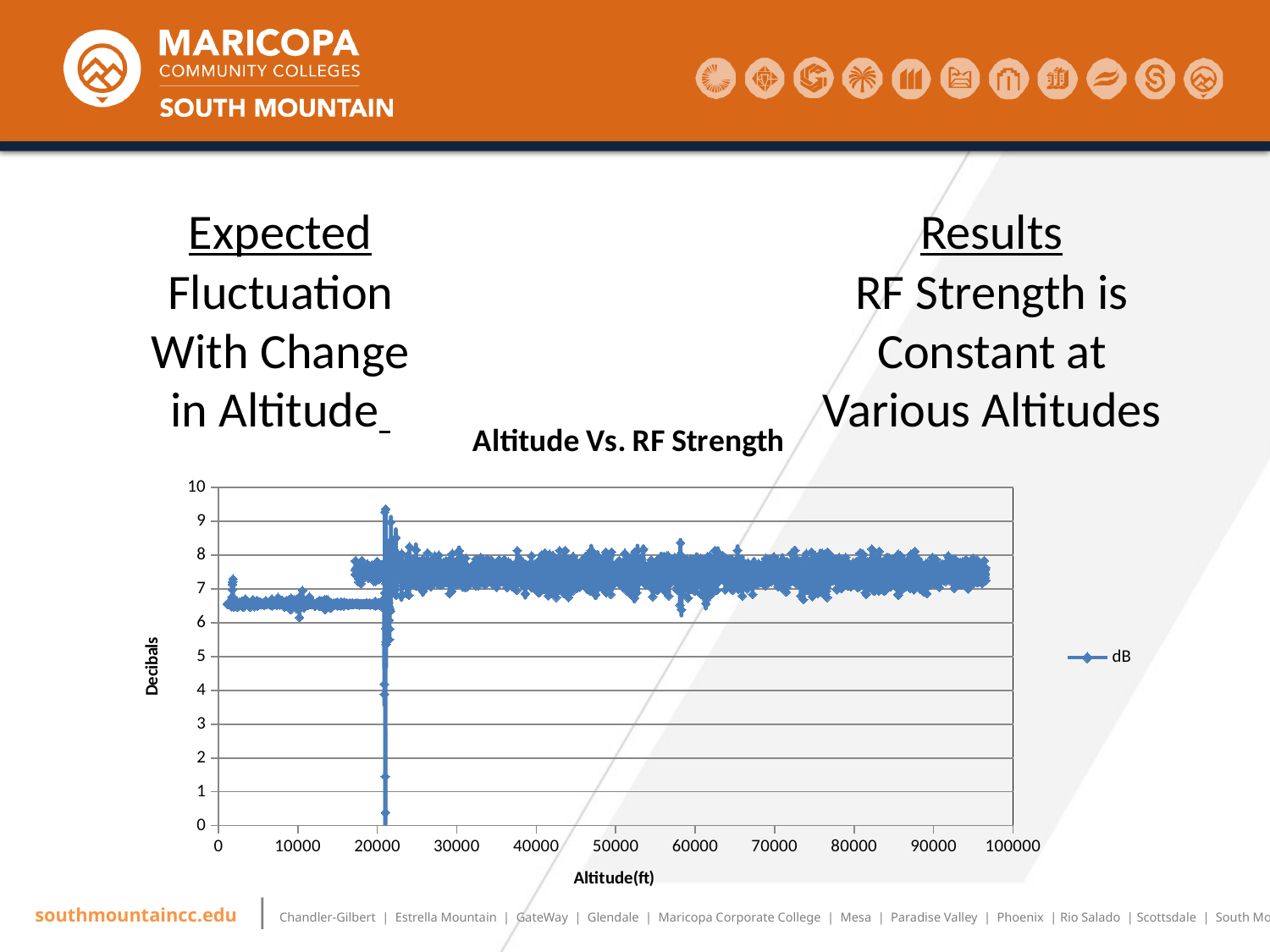
Is the lowest plotted dB value greater or less than 1? less What kind of chart is shown on the slide? scatter chart Is the dB value at an altitude of 90000 ft greater or less than 9? less How many series does the chart legend list? 1 Is the dB value at an altitude of 10000 ft greater or less than 7? less What is the label of the x axis of the chart? Altitude(ft) Which is larger, the dB value at 5000 ft or the dB value at 60000 ft? 60000 ft What is the title of the chart? Altitude Vs. RF Strength